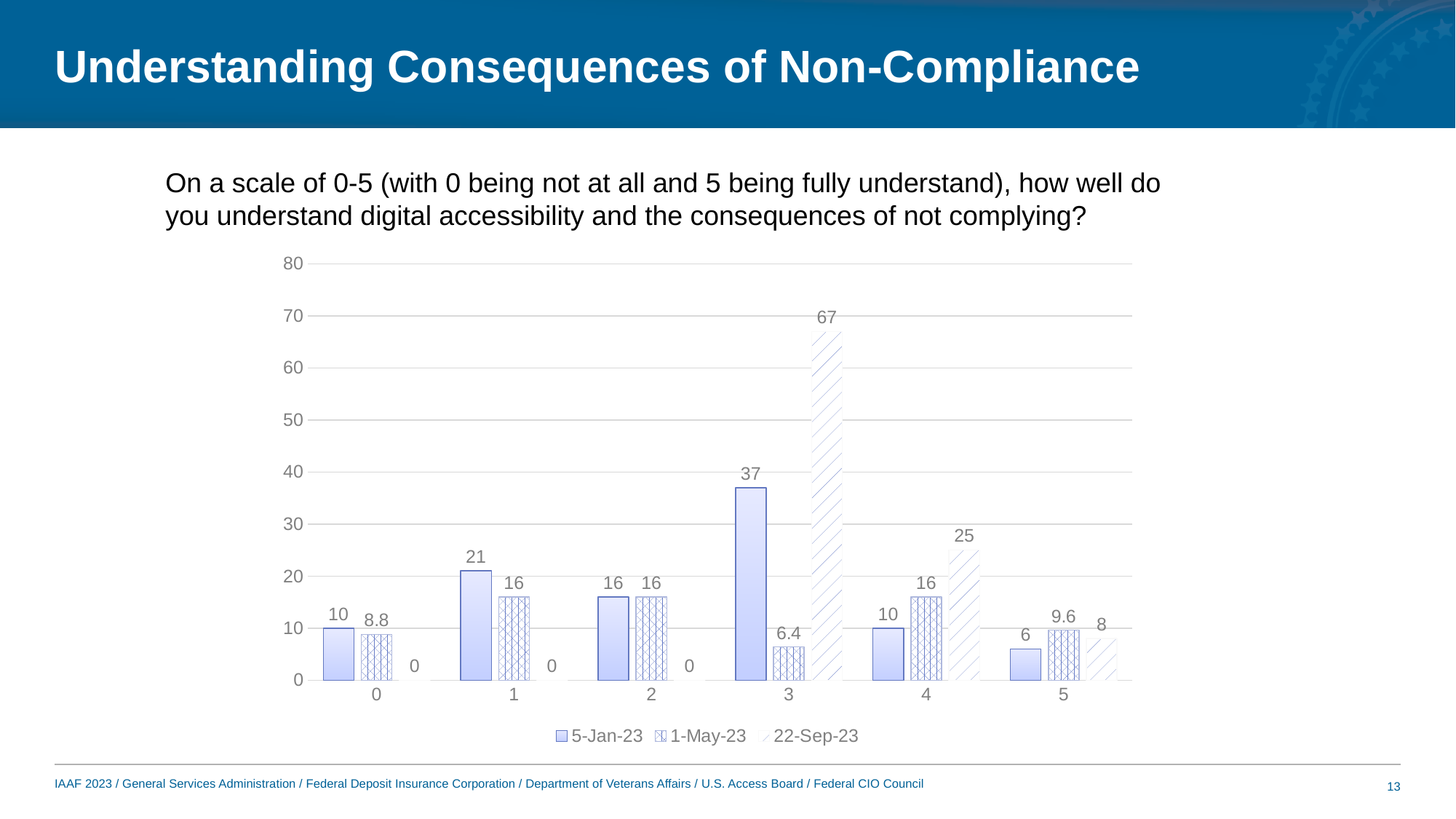
What is the value for category 3 in the 22-Sep-23 series? 67 Which category has the lowest value in the 1-May-23 series? 3 How many series does the legend list? 3 Which is larger for category 4: the 1-May-23 value or the 22-Sep-23 value? 22-Sep-23 What is the value for category 5 in the 22-Sep-23 series? 8 What kind of chart is shown on the slide? bar chart Which category has the highest value in the 5-Jan-23 series? 3 What is the difference between the 22-Sep-23 value for category 3 and the 5-Jan-23 value for category 3? 30 What is the value for category 1 in the 5-Jan-23 series? 21 How many categories are shown on the x axis? 6 What is the value for category 0 in the 1-May-23 series? 8.8 What is the total of the three series values for category 5? 23.6